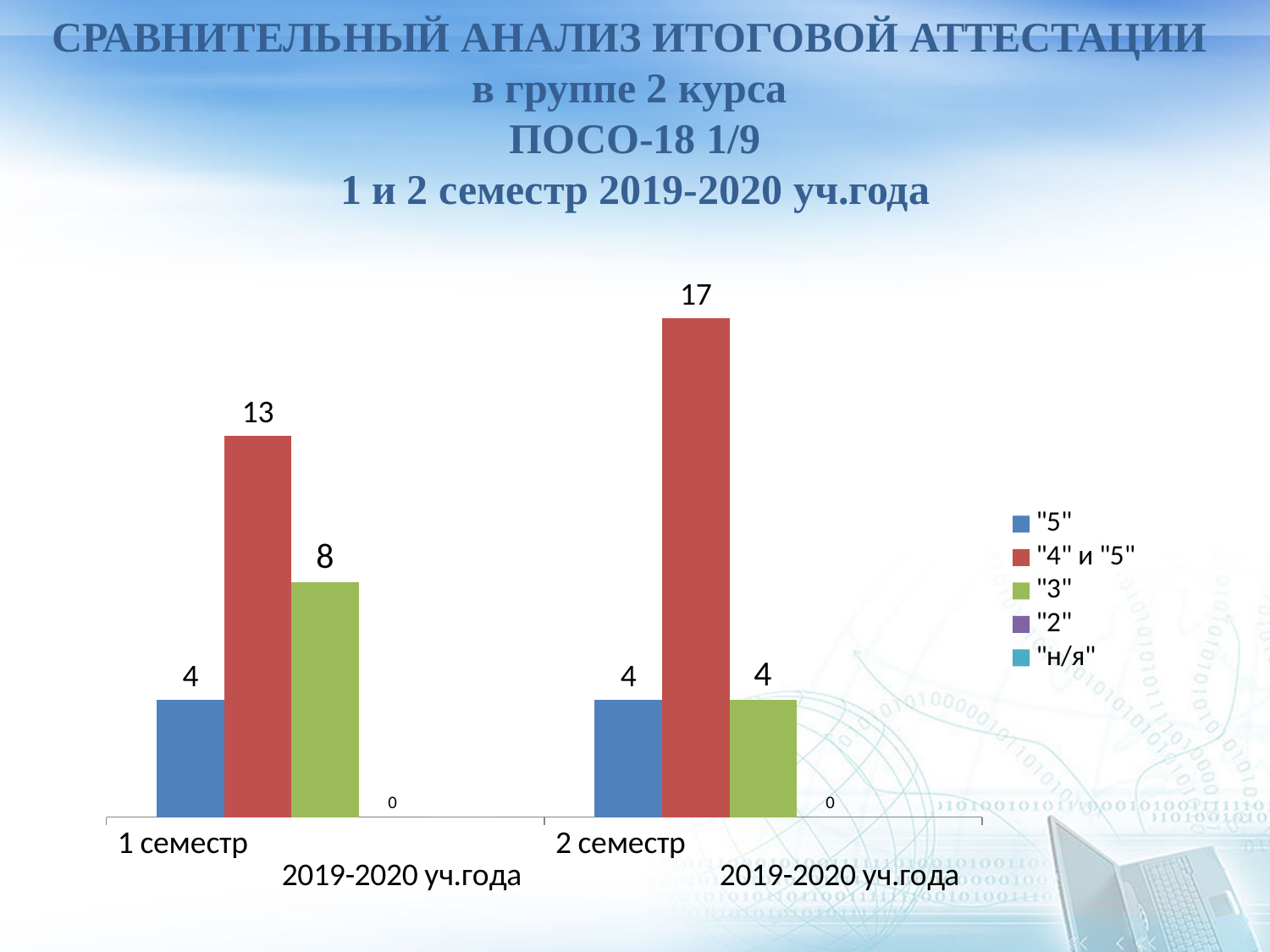
What is the value for "3" in 1 семестр 2019-2020 уч.года? 8 What kind of chart is shown on the slide? bar chart Which is larger: the "3" value in 1 семестр or the "3" value in 2 семестр? 1 семестр What is the difference between the "4" и "5" values for 2 семестр and 1 семестр? 4 What is the value for "4" и "5" in 1 семестр 2019-2020 уч.года? 13 Does the "4" и "5" value rise or fall from 1 семестр to 2 семестр? rise What is the value for "5" in 2 семестр 2019-2020 уч.года? 4 How many categories are shown on the x axis? 2 What colour are the bars for the "4" и "5" series? red What is the value for "4" и "5" in 2 семестр 2019-2020 уч.года? 17 Which series has the highest value in 2 семестр 2019-2020 уч.года? "4" и "5" How many series does the legend list? 5